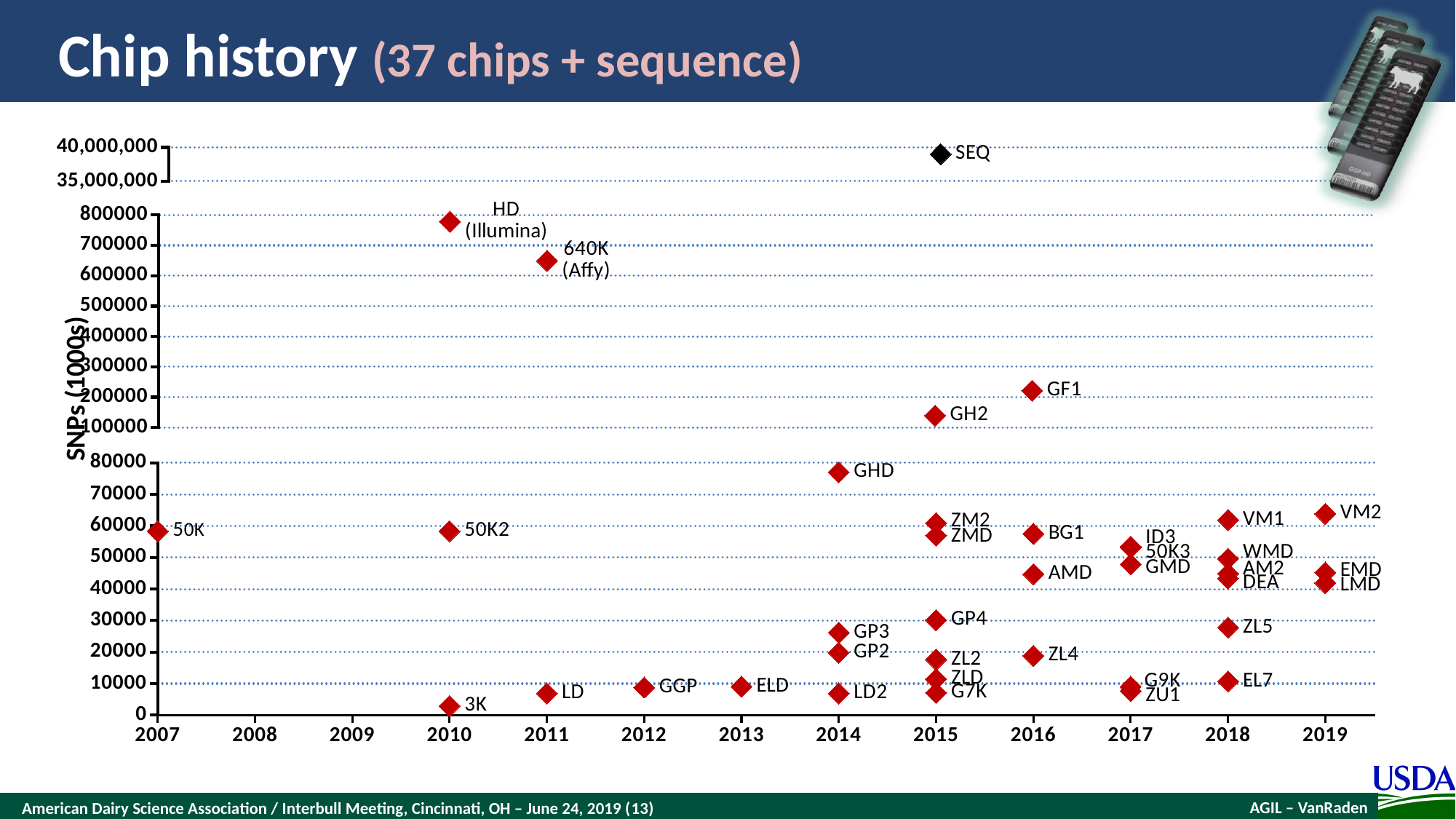
Is the value for GF1 greater or less than 200000? greater What kind of chart is shown on the slide? scatter chart Is the value for HD (Illumina) greater or less than 700000? greater Which chip has the lowest number of SNPs? 3K Is the value for 3K greater or less than 10000? less Which has more SNPs, GP4 or GP2? GP4 What is the label of the y axis? SNPs (1000s) Which point has the highest number of SNPs? SEQ Which has more SNPs, HD (Illumina) or 640K (Affy)? HD (Illumina) How many chips are plotted in the year 2010? 3